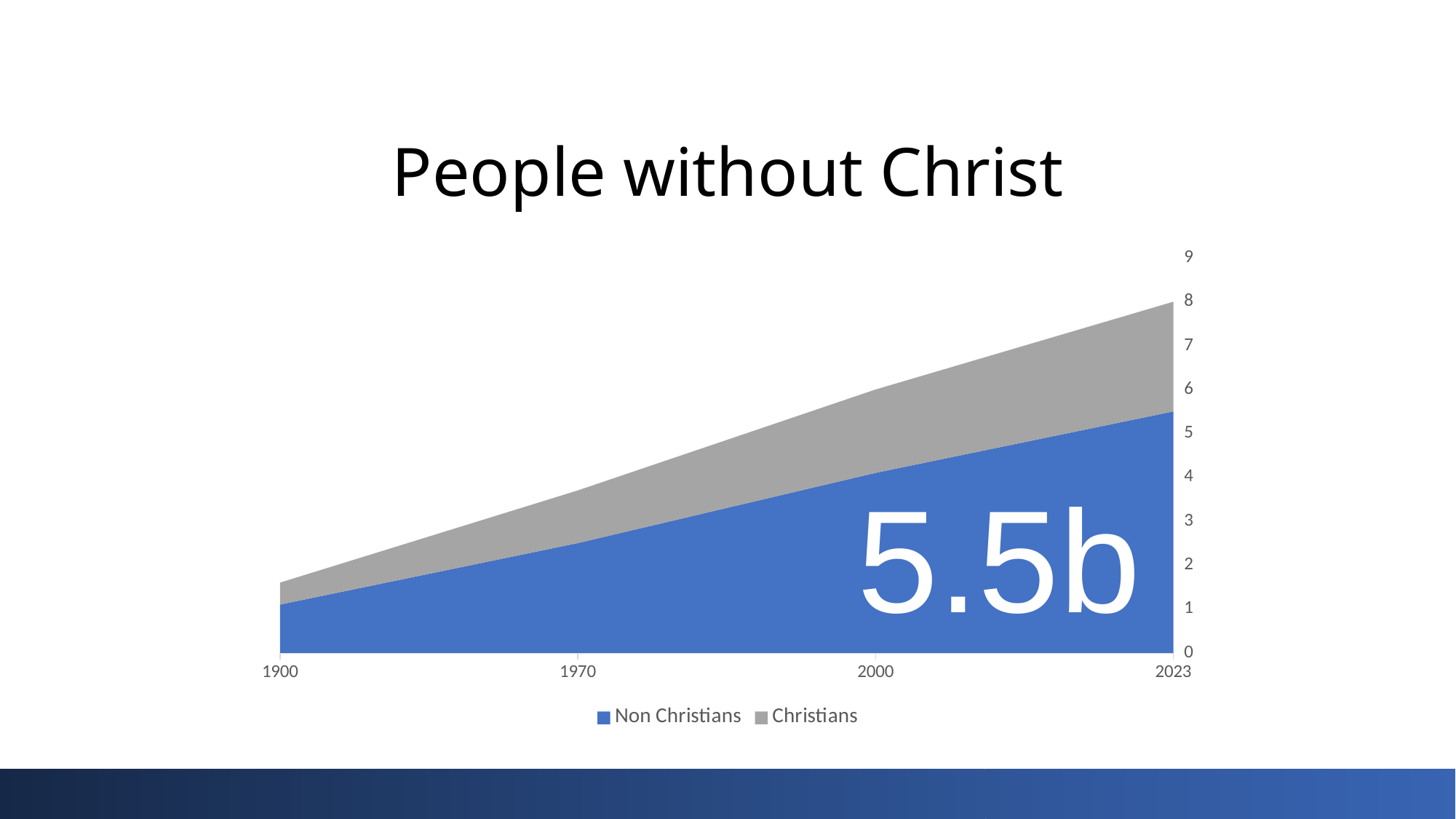
Is the total for 2023 greater or less than 7? greater Is the value for Non Christians in 2023 greater or less than 5? greater Which year has the lowest total? 1900 Is the value for Non Christians in 1970 greater or less than 2? greater What kind of chart is shown on the slide? area chart Which year has the highest total? 2023 How many series does the legend list? 2 What large value is printed over the blue area of the chart? 5.5b In 2023, which series is larger, Non Christians or Christians? Non Christians Do the values rise or fall from 1900 to 2023? rise How many years are marked along the x axis? 4